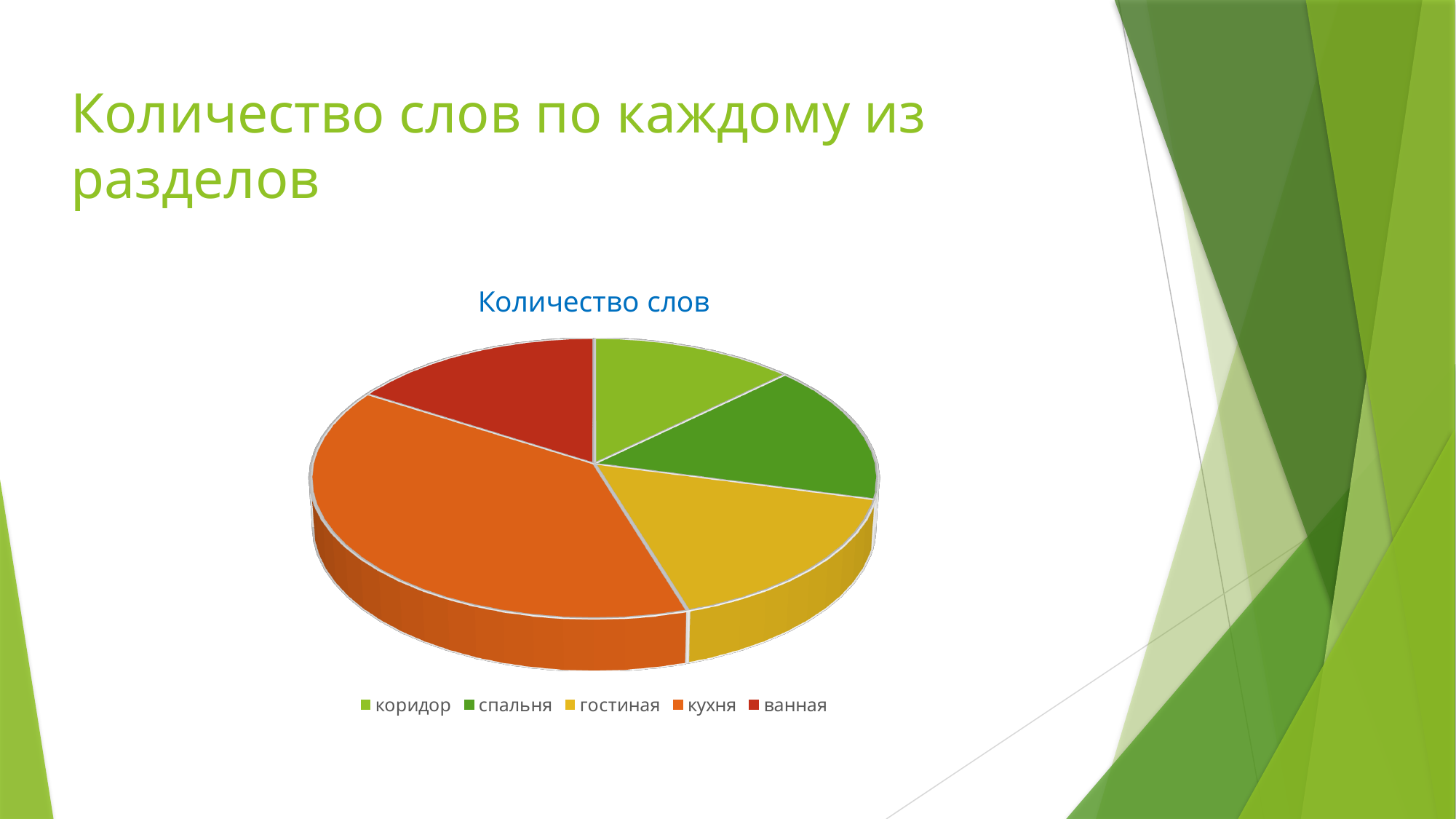
How many entries does the legend list? 5 What kind of chart is shown on the slide? pie chart Which slice is larger, кухня or ванная? кухня Which category has the largest slice of the pie? кухня Which category is listed first in the legend? коридор Which slice is larger, гостиная or коридор? гостиная How many categories (slices) does the pie chart have? 5 Which slice is larger, кухня or гостиная? кухня What colour is the slice for кухня? orange What is the title of the chart? Количество слов